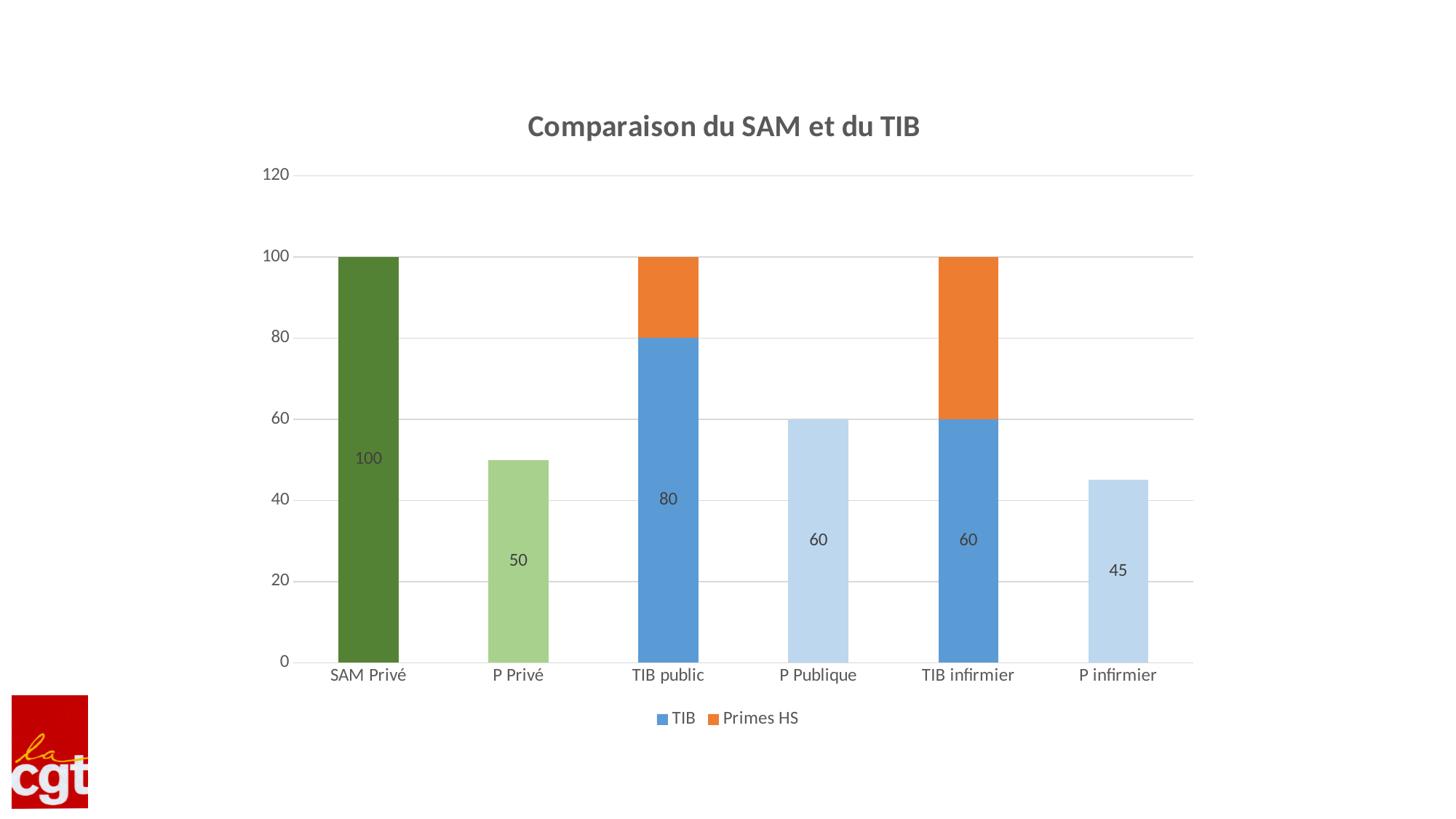
What is the value of the P infirmier bar? 45 How many categories are shown on the x axis? 6 What is the difference between the P Publique value and the P Privé value? 10 What is the TIB value for TIB public? 80 What is the value of the SAM Privé bar? 100 How many series does the legend list? 2 Which category has the lowest labelled value? P infirmier What is the value of the P Publique bar? 60 Which has the larger TIB value, TIB public or TIB infirmier? TIB public Is the value for P infirmier greater or less than 60? less What is the TIB value for TIB infirmier? 60 What is the value of the P Privé bar? 50